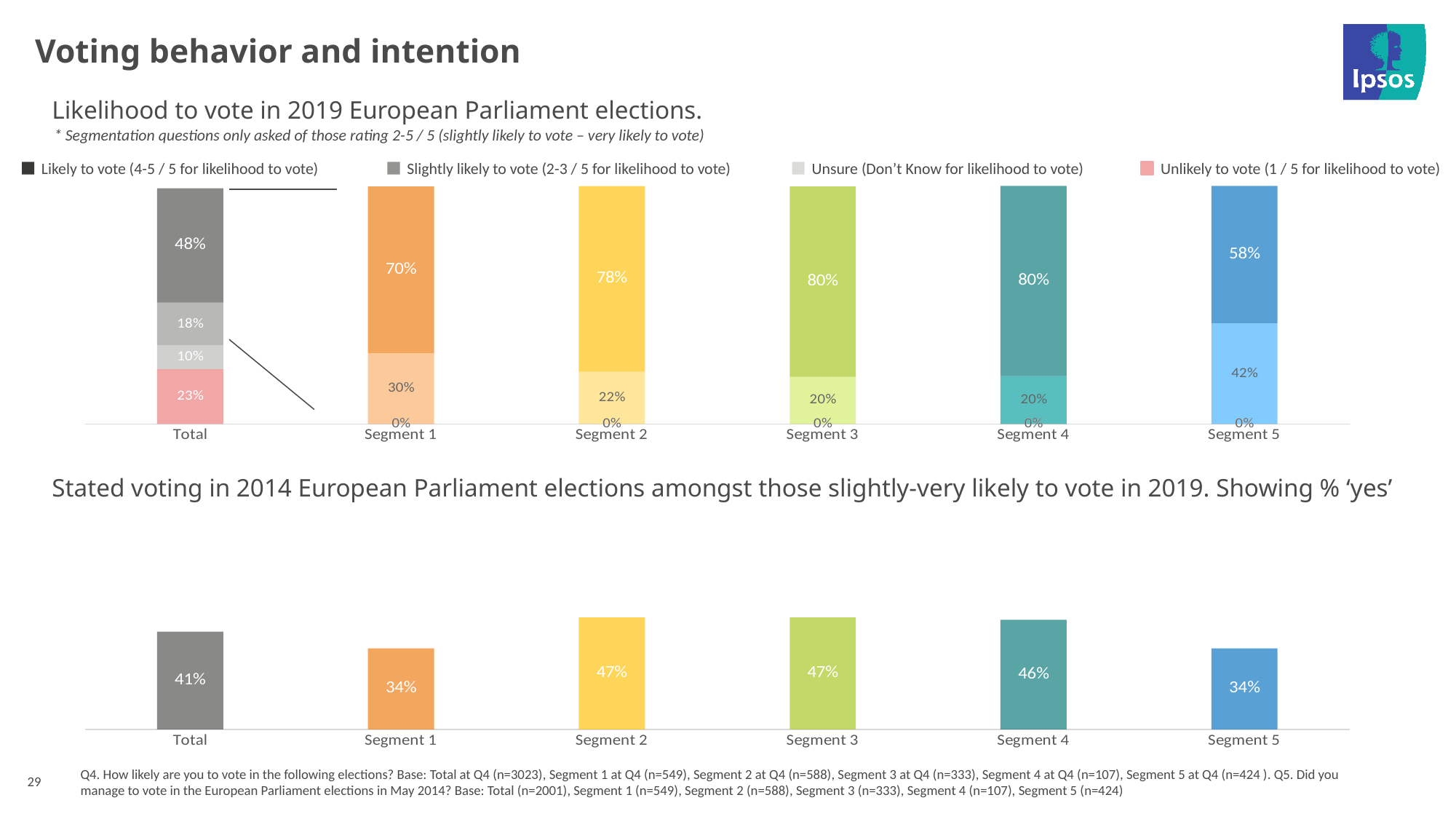
How many series does the legend of the top chart on likelihood to vote in 2019 list? 4 In the bottom chart on stated voting in 2014, is the value for Total larger or smaller than the value for Segment 1? Larger In the bottom chart on stated voting in 2014, which category has the highest value? Segment 2 and Segment 3 (47%) How many categories are shown on the x axis of the bottom chart on stated voting in 2014? 6 In the top chart on likelihood to vote in 2019, what percentage of the Total are unlikely to vote? 23% In the top chart on likelihood to vote in 2019, what is the difference between the 'likely to vote' share of Segment 2 and Segment 1? 8 percentage points In the top chart on likelihood to vote in 2019, what percentage of the Total are likely to vote (4-5 / 5)? 48% In the bottom chart on stated voting in 2014, what is the value for Segment 4? 46% In the top chart on likelihood to vote in 2019, what percentage of Segment 5 are slightly likely to vote? 42% What kind of chart is the top chart on likelihood to vote in 2019? Stacked bar chart In the bottom chart on stated voting in 2014, what is the difference between the Total value and the Segment 5 value? 7 percentage points In the top chart on likelihood to vote in 2019, which segment has the lowest 'likely to vote' share among Segments 1 to 5? Segment 5